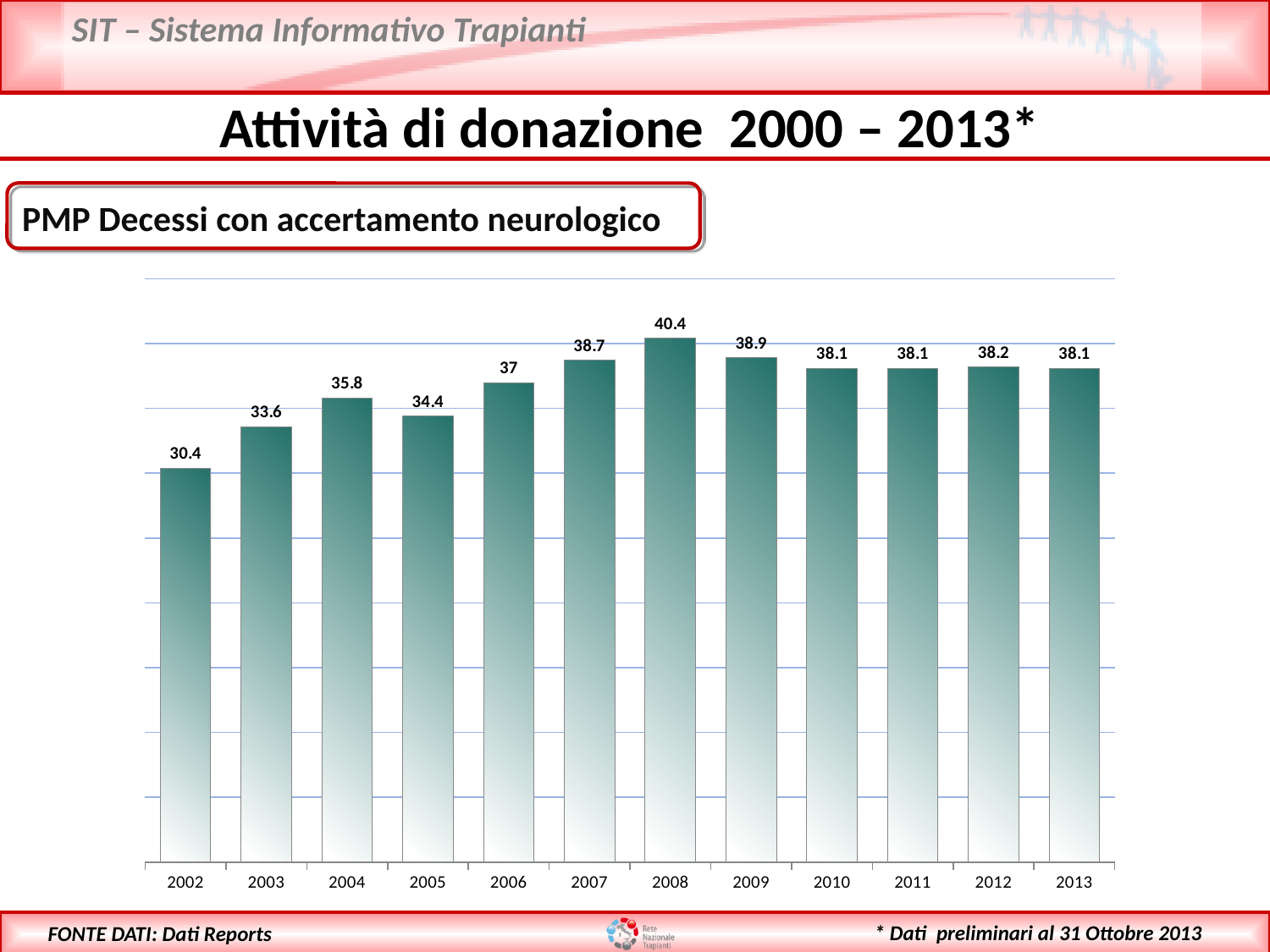
What is the value for 2012? 38.2 What is the difference between the values for 2004 and 2003? 2.2 How many years are shown on the x axis? 12 What is the difference between the values for 2008 and 2002? 10 What is the value for 2002? 30.4 What kind of chart is this? bar chart What is the value for 2006? 37 Which year has the lowest value? 2002 What is the value for 2008? 40.4 Which is larger, the value for 2005 or the value for 2007? 2007 Do the values rise or fall from 2002 to 2008? rise Which year has the highest value? 2008